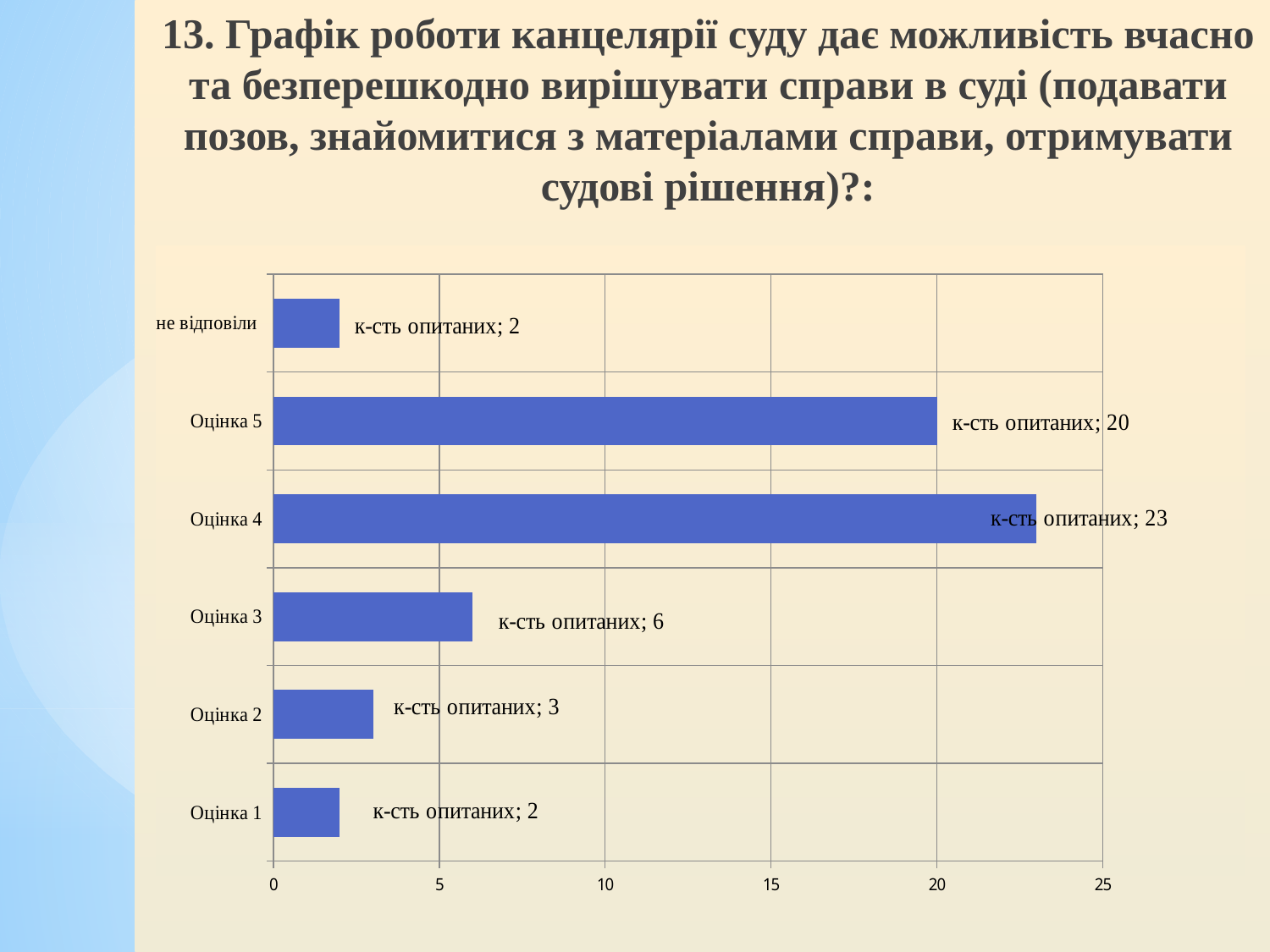
What is the value for Оцінка 2? 3 What is the value for Оцінка 4? 23 How many categories are shown in the chart? 6 What is the value for Оцінка 5? 20 What is the name of the data series shown in the data labels? к-сть опитаних Is the value for Оцінка 5 greater or less than 15? greater Which category has the highest value? Оцінка 4 What is the difference between the values for Оцінка 4 and Оцінка 5? 3 Which is larger, the value for Оцінка 3 or the value for Оцінка 2? Оцінка 3 What kind of chart is shown on the slide? bar chart What is the value for Оцінка 3? 6 What is the value for не відповіли? 2